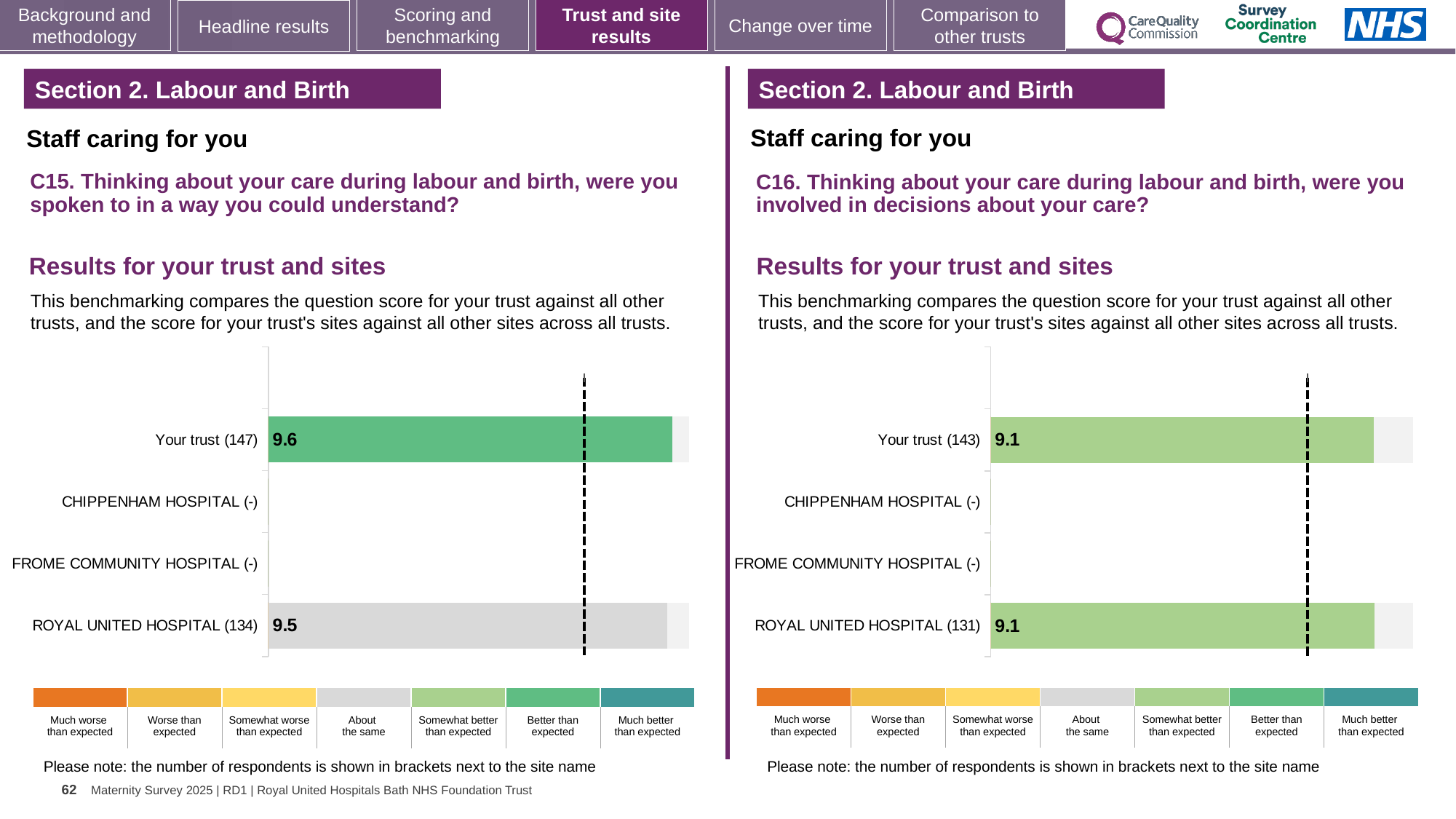
In the C16 chart on the right, what is the score for ROYAL UNITED HOSPITAL (131)? 9.1 In the C15 chart on the left, what is the difference between the score for Your trust and the score for ROYAL UNITED HOSPITAL? 0.1 In the C16 chart on the right, how many respondents are shown in brackets for ROYAL UNITED HOSPITAL? 131 In the C15 chart on the left, which category has the highest plotted score? Your trust (147) How many site/trust categories are listed on the y axis of the C16 chart on the right? 4 In the C15 chart on the left, which benchmark category does the grey colour of the ROYAL UNITED HOSPITAL bar represent according to the legend? About the same How many benchmark categories does the legend below the C16 chart on the right list? 7 In the C15 chart on the left, what is the score for Your trust (147)? 9.6 In the C16 chart on the right, what is the score for Your trust (143)? 9.1 What kind of chart is the C15 chart on the left? Bar chart In the C15 chart on the left, which has the higher score: Your trust or ROYAL UNITED HOSPITAL? Your trust In the C15 chart on the left, what is the score for ROYAL UNITED HOSPITAL (134)? 9.5